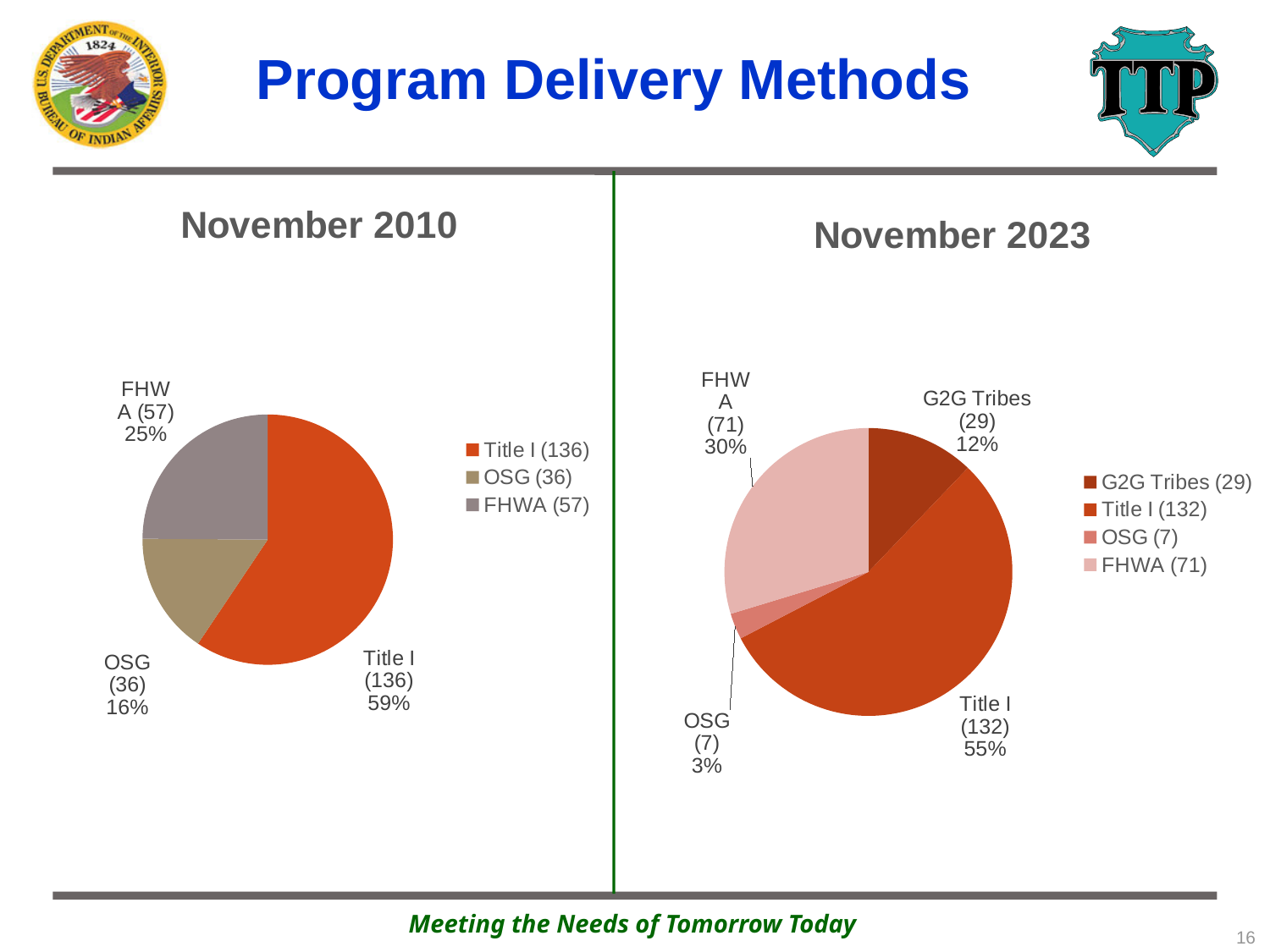
How many entries does the legend of the November 2010 chart list? 3 In the November 2023 chart, which is larger, FHWA or G2G Tribes? FHWA What kind of chart is the November 2010 chart? Pie chart In the November 2010 chart, what is the difference between the Title I value and the FHWA value? 79 In the November 2010 chart, which category has the smallest slice? OSG How many categories does the November 2023 chart show? 4 In the November 2010 chart, which category has the largest slice? Title I In the November 2010 chart, what percentage share does Title I have? 59% In the November 2023 chart, what percentage share does FHWA have? 30% In the November 2023 chart, which category has the smallest slice? OSG In the November 2023 chart, what is the value for G2G Tribes? 29 In the November 2010 chart, what is the value for OSG? 36